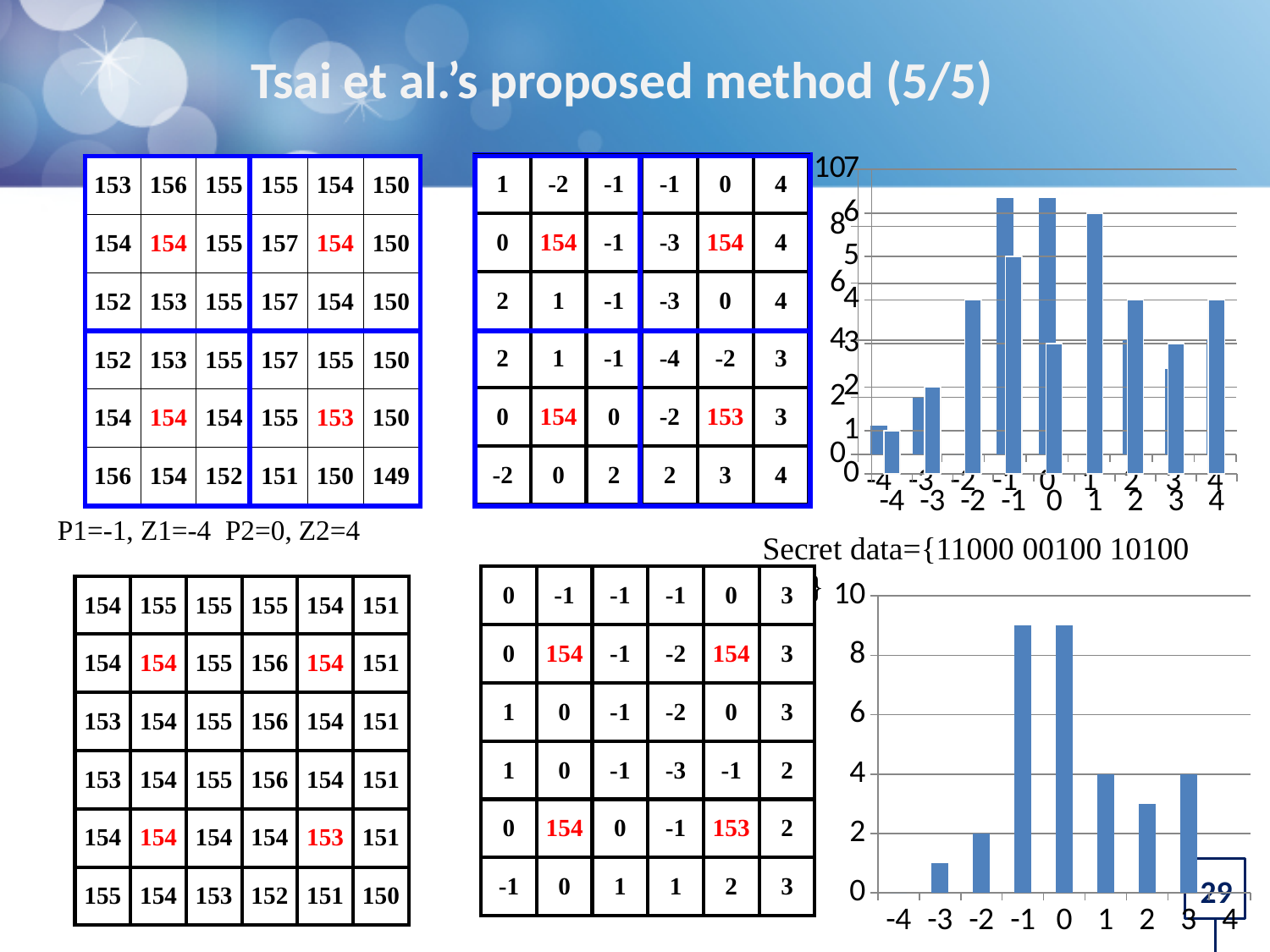
In the bottom-right chart, is the value for category -1 greater or less than 8? greater In the bottom-right chart, how many categories are labelled on the x axis? 9 What kind of chart is the bottom-right chart? bar chart In the bottom-right chart, what is the difference between the value for 3 and the value for -2? 2 In the bottom-right chart, which is larger, the value for 2 or the value for 3? 3 In the bottom-right chart, is the value for category -3 greater or less than 2? less In the bottom-right chart, which is larger, the value for -1 or the value for 1? -1 In the bottom-right chart, is the value for category 2 greater or less than 4? less In the bottom-right chart, what is the value for category 1? 4 In the bottom-right chart, what is the value for category 3? 4 In the bottom-right chart, what is the value for category -2? 2 In the bottom-right chart, do the values rise or fall from category -4 to category -1? rise